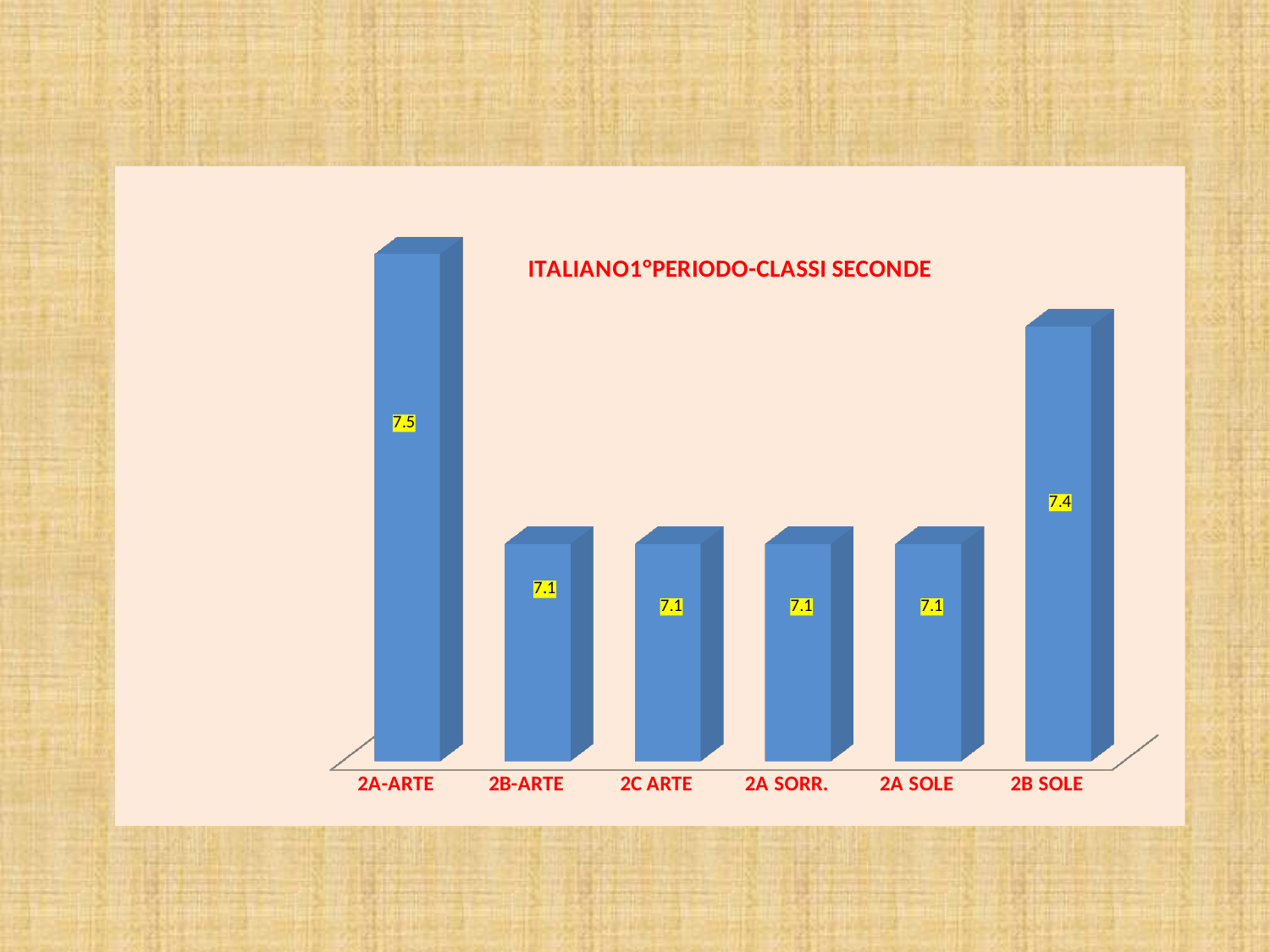
What is the difference between the values for 2B SOLE and 2A SOLE? 0.3 What is the value for 2A SORR.? 7.1 Which category has the highest value? 2A-ARTE What is the title of the chart? ITALIANO1°PERIODO-CLASSI SECONDE What kind of chart is shown on the slide? bar chart How many categories are shown on the x axis? 6 What is the value for 2C ARTE? 7.1 What is the value for 2A-ARTE? 7.5 Which is larger, the value for 2A-ARTE or the value for 2B SOLE? 2A-ARTE What is the difference between the values for 2A-ARTE and 2B-ARTE? 0.4 What is the value for 2B SOLE? 7.4 How many categories have a value of 7.1? 4